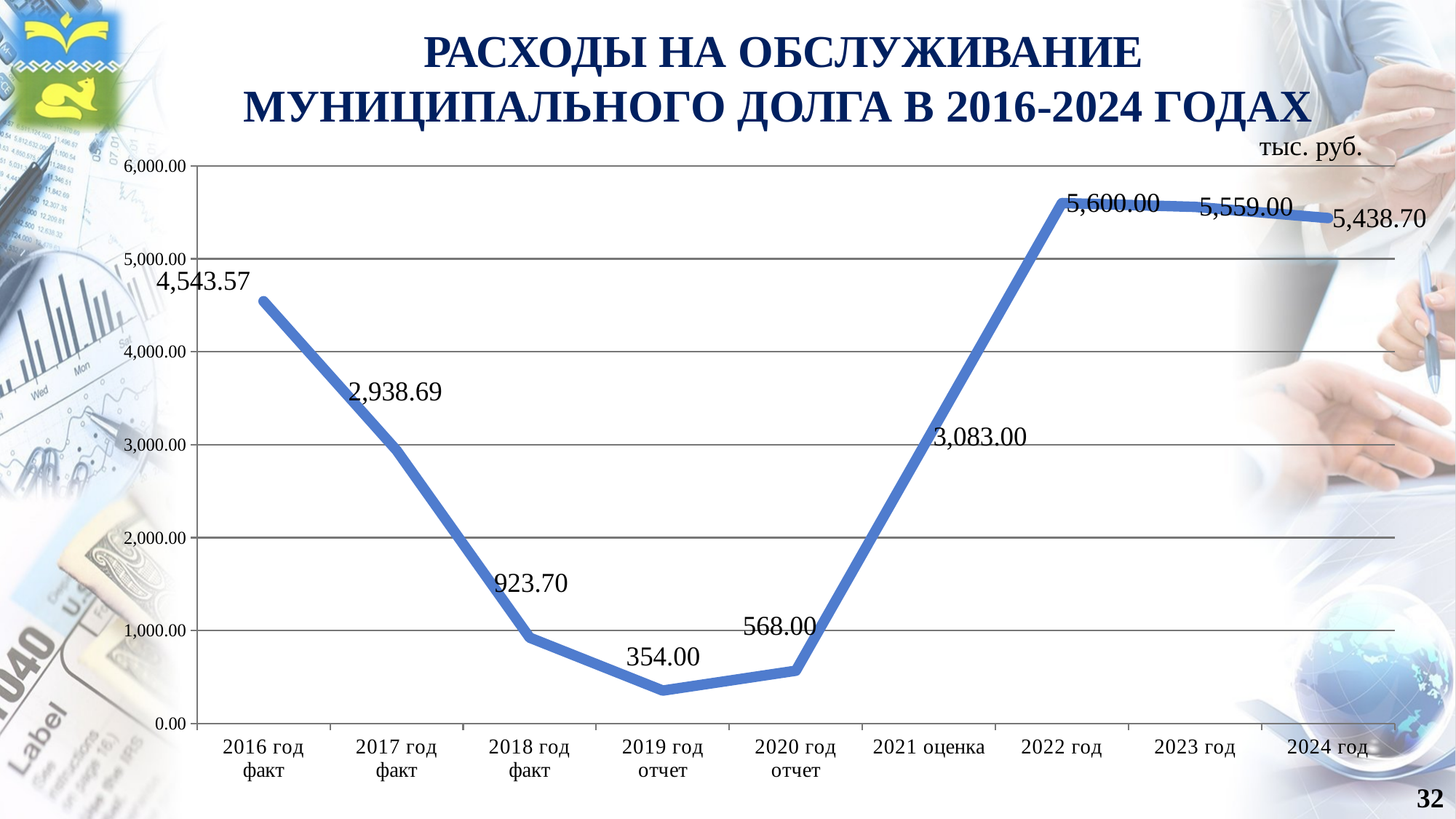
What is the value for 2021 оценка? 3,083.00 Do the values rise or fall from 2016 год факт to 2019 год отчет? Fall What is the difference between the values for 2022 год and 2023 год? 41.00 What is the value for 2022 год? 5,600.00 What unit is indicated above the chart? тыс. руб. What is the value for 2019 год отчет? 354.00 Which year has the lowest value? 2019 год отчет How many data points are plotted on the chart? 9 Which is larger, the value for 2017 год факт or the value for 2021 оценка? 2021 оценка What is the value for 2016 год факт? 4,543.57 Which year has the highest value? 2022 год What kind of chart is shown on the slide? Line chart